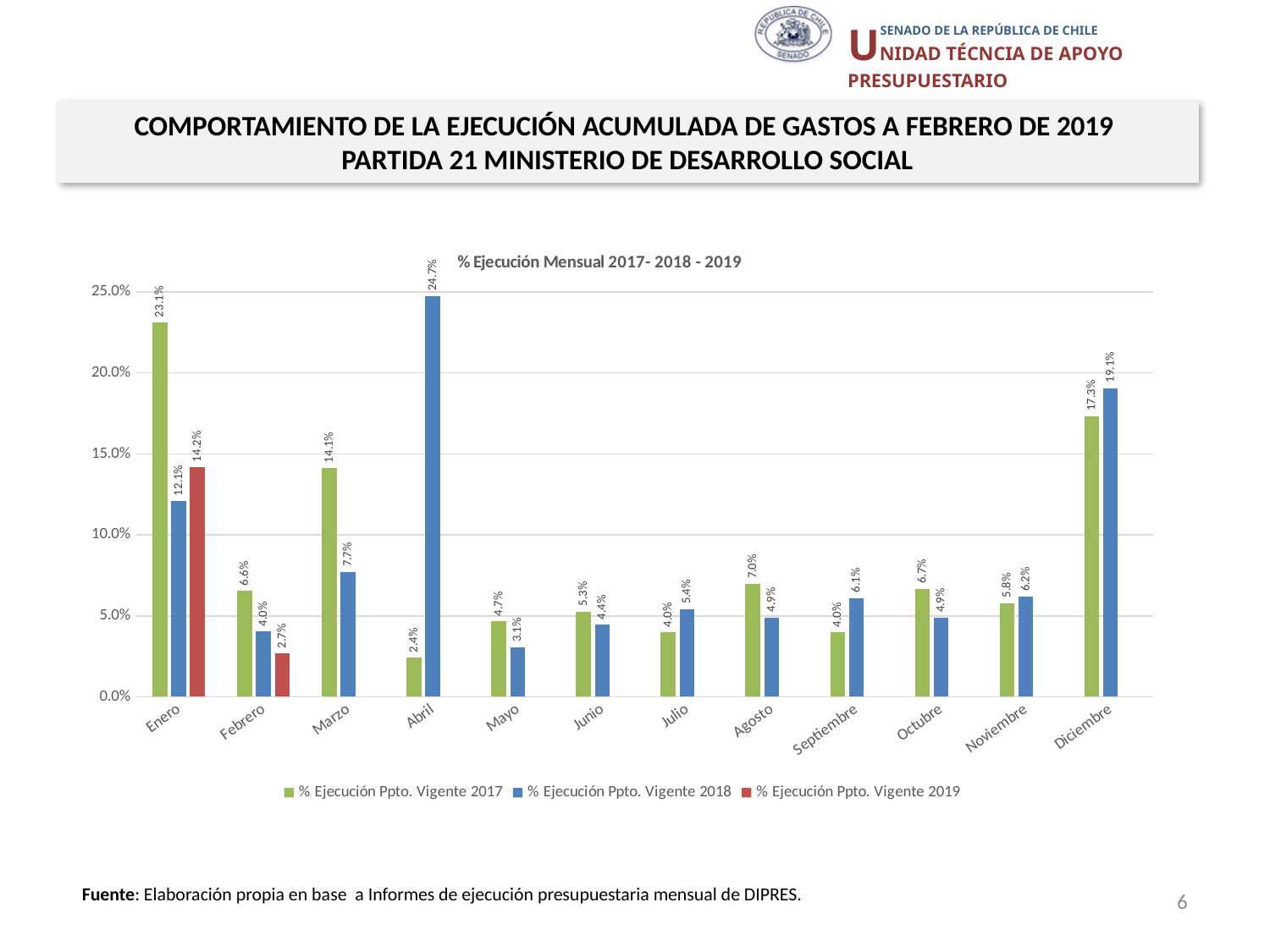
What kind of chart is shown? bar chart How many months are shown on the x axis? 12 What is the value for % Ejecución Ppto. Vigente 2018 in Abril? 24.7% What is the title of the chart? % Ejecución Mensual 2017- 2018 - 2019 Which month has the lowest value for % Ejecución Ppto. Vigente 2018? Mayo What is the value for % Ejecución Ppto. Vigente 2017 in Diciembre? 17.3% In Marzo, which is larger: the 2017 value or the 2018 value? 2017 What is the value for % Ejecución Ppto. Vigente 2019 in Febrero? 2.7% What is the difference between the 2019 and 2018 values in Enero? 2.1% Which month has the highest value for % Ejecución Ppto. Vigente 2017? Enero Is the value for % Ejecución Ppto. Vigente 2018 in Diciembre greater or less than 15.0%? greater How many series does the legend list? 3